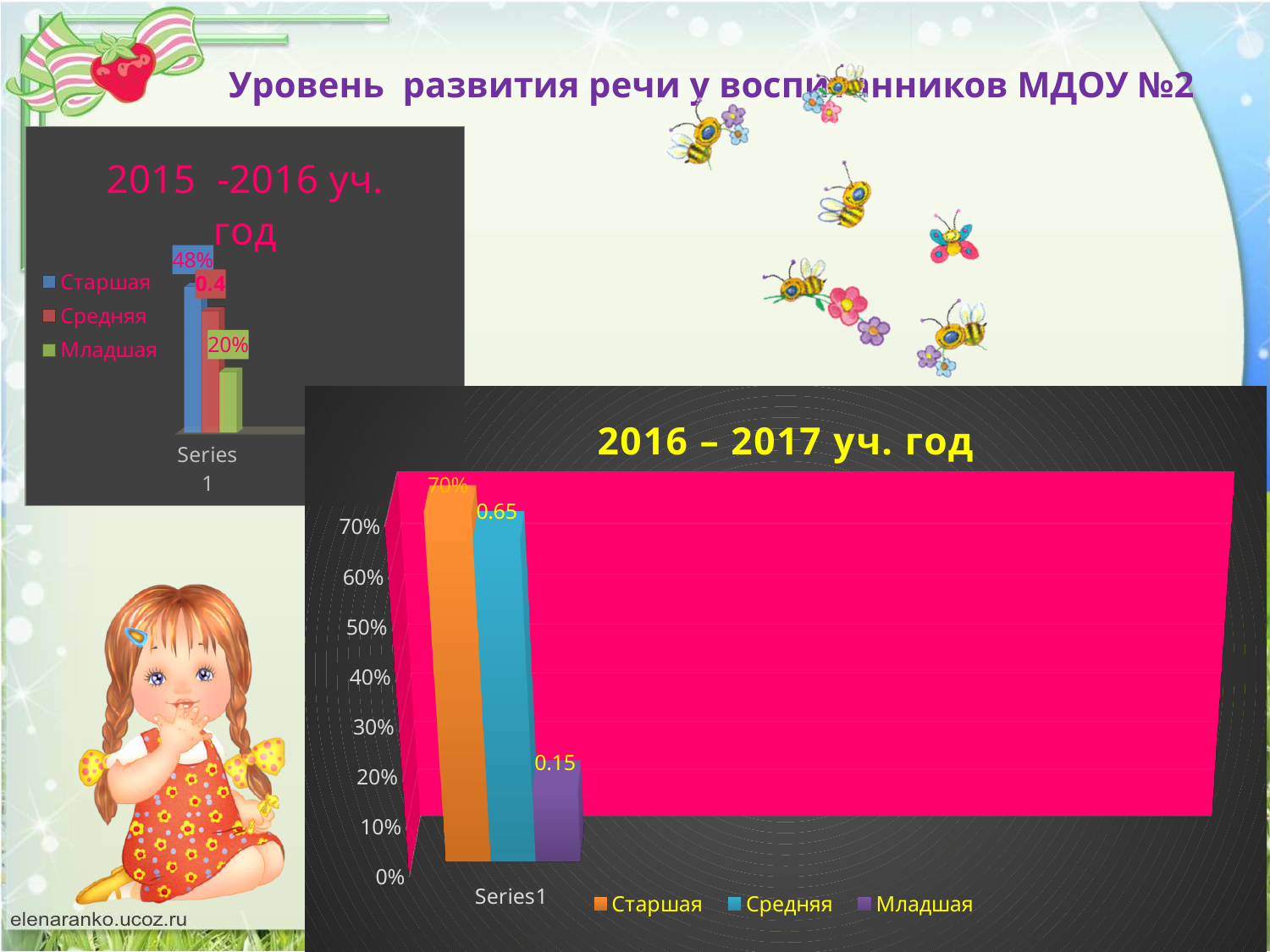
In the chart titled "2016 – 2017 уч. год", is the value for Младшая greater or less than 20%? less In the chart titled "2016 – 2017 уч. год", what is the value for Средняя? 0.65 What kind of chart is the chart titled "2016 – 2017 уч. год"? bar chart In the chart titled "2016 – 2017 уч. год", what is the value for Старшая? 70% In the chart titled "2016 – 2017 уч. год", which is larger, Старшая or Средняя? Старшая In the chart titled "2016 – 2017 уч. год", which series has the highest value? Старшая How many series does the legend of the chart titled "2016 – 2017 уч. год" list? 3 In the chart titled "2016 – 2017 уч. год", which series has the lowest value? Младшая In the chart titled "2015 -2016 уч. год", what is the value for Старшая? 48% In the chart titled "2016 – 2017 уч. год", what is the value for Младшая? 0.15 In the chart titled "2015 -2016 уч. год", what is the value for Младшая? 20% In the chart titled "2015 -2016 уч. год", which series has the lowest value? Младшая